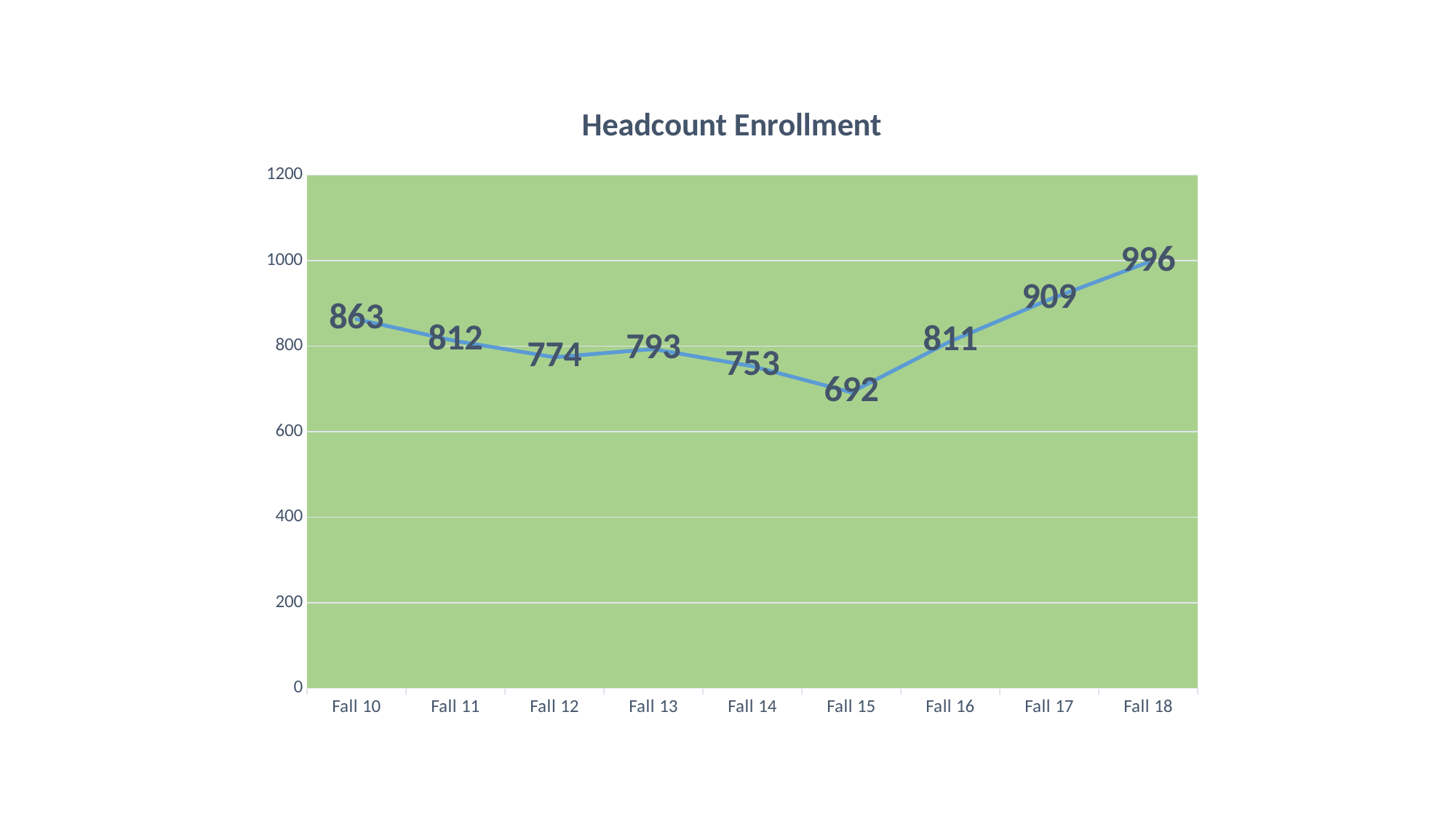
How many terms are plotted on the chart? 9 Does headcount enrollment rise or fall from Fall 15 to Fall 18? rise What is the headcount enrollment for Fall 15? 692 What is the headcount enrollment for Fall 12? 774 What is the difference in headcount enrollment between Fall 10 and Fall 11? 51 What is the headcount enrollment for Fall 18? 996 Which term has the lowest headcount enrollment? Fall 15 Which is larger, the headcount enrollment for Fall 13 or Fall 14? Fall 13 What is the difference in headcount enrollment between Fall 18 and Fall 15? 304 Is the headcount enrollment for Fall 17 greater or less than 1000? less What kind of chart is shown on the slide? line chart Which term has the highest headcount enrollment? Fall 18